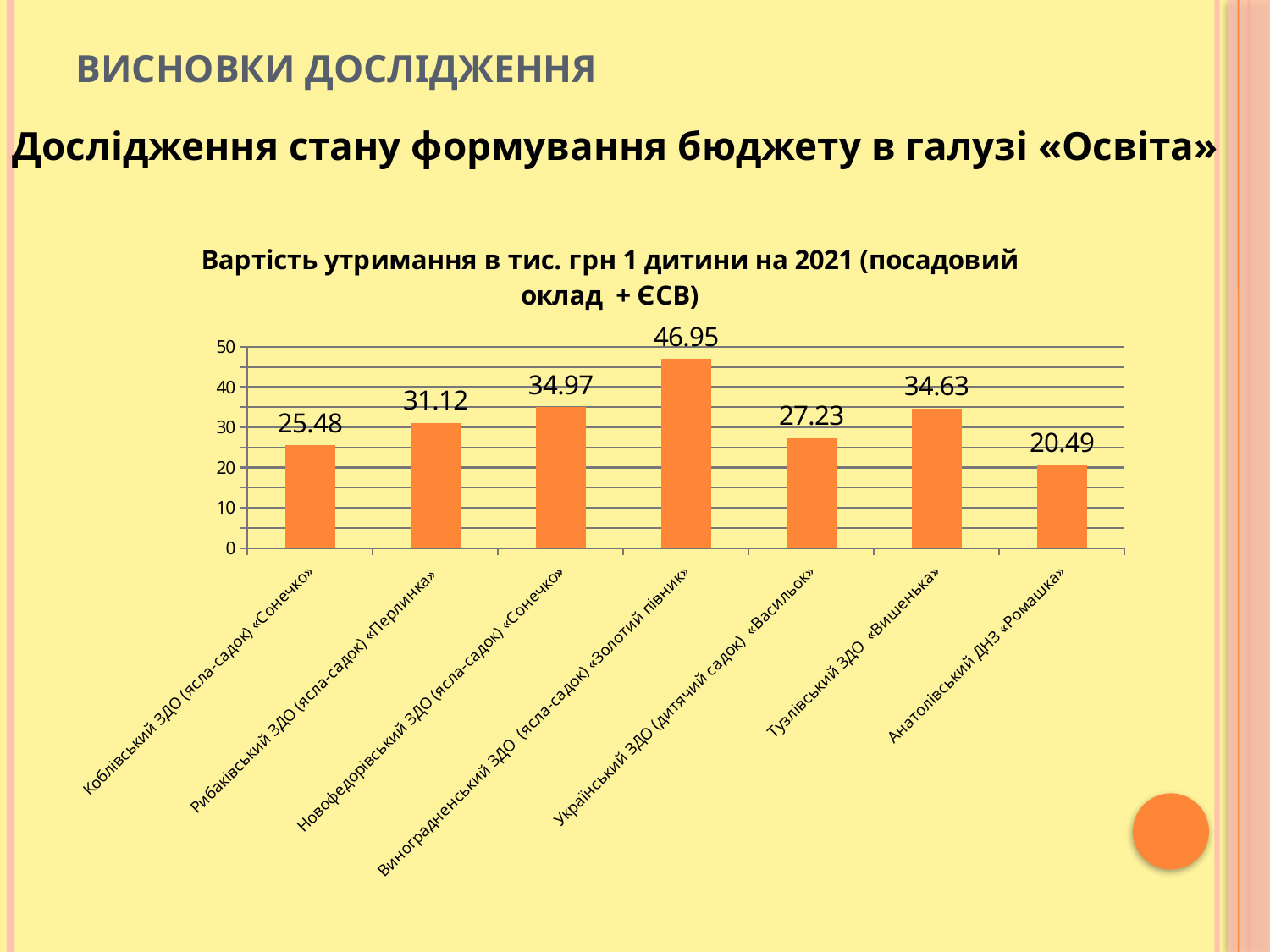
Which category has the highest value? Виноградненський ЗДО (ясла-садок) «Золотий півник» Is the value for Коблівський ЗДО (ясла-садок) «Сонечко» greater or less than 30? less Which category has the lowest value? Анатолівський ДНЗ «Ромашка» What is the value for Рибаківський ЗДО (ясла-садок) «Перлинка»? 31.12 Which is larger, the value for Український ЗДО (дитячий садок) «Васильок» or the value for Тузлівський ЗДО «Вишенька»? Тузлівський ЗДО «Вишенька» What is the difference between the values for Новофедорівський ЗДО (ясла-садок) «Сонечко» and Коблівський ЗДО (ясла-садок) «Сонечко»? 9.49 What kind of chart is shown on the slide? bar chart How many categories are shown in the chart? 7 What is the value for Виноградненський ЗДО (ясла-садок) «Золотий півник»? 46.95 What is the value for Анатолівський ДНЗ «Ромашка»? 20.49 What is the difference between the values for Виноградненський ЗДО (ясла-садок) «Золотий півник» and Анатолівський ДНЗ «Ромашка»? 26.46 What is the title of the chart? Вартість утримання в тис. грн 1 дитини на 2021 (посадовий оклад + ЄСВ)